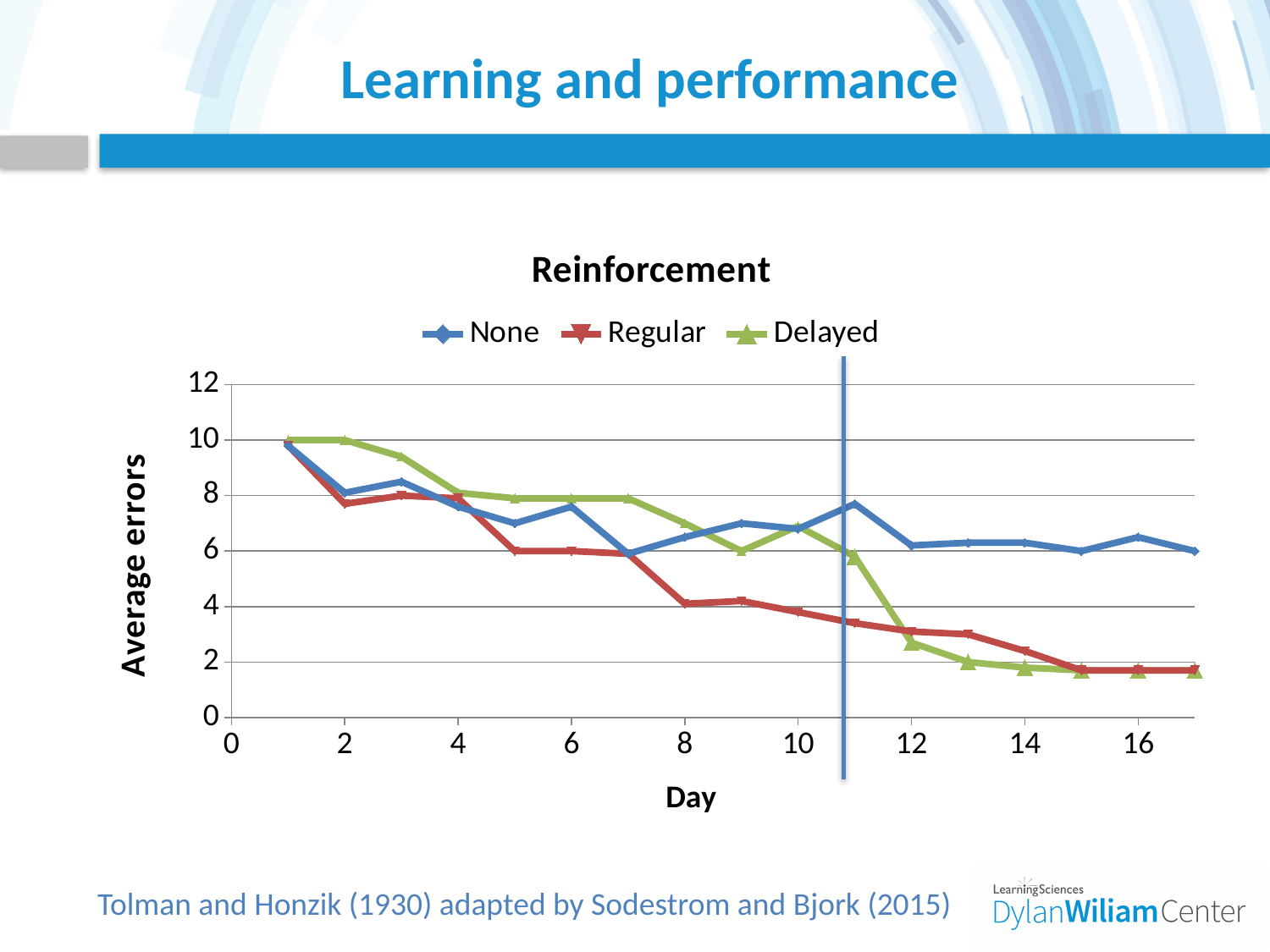
Is the value for the None series on day 11 greater or less than 6? greater What is the title of the chart? Reinforcement Is the value for the Regular series on day 8 greater or less than 6? less Is the value for the Delayed series on day 12 greater or less than 4? less What is the value for the Delayed series on day 13? 2 What is the value for the None series on day 17? 6 How many series does the legend list? 3 What is the value for the Regular series on day 5? 6 On day 11, which series has the higher value, Delayed or Regular? Delayed Do the values for the Regular series rise or fall from day 1 to day 17? fall What kind of chart is shown on the slide? line chart What is the label on the vertical axis? Average errors